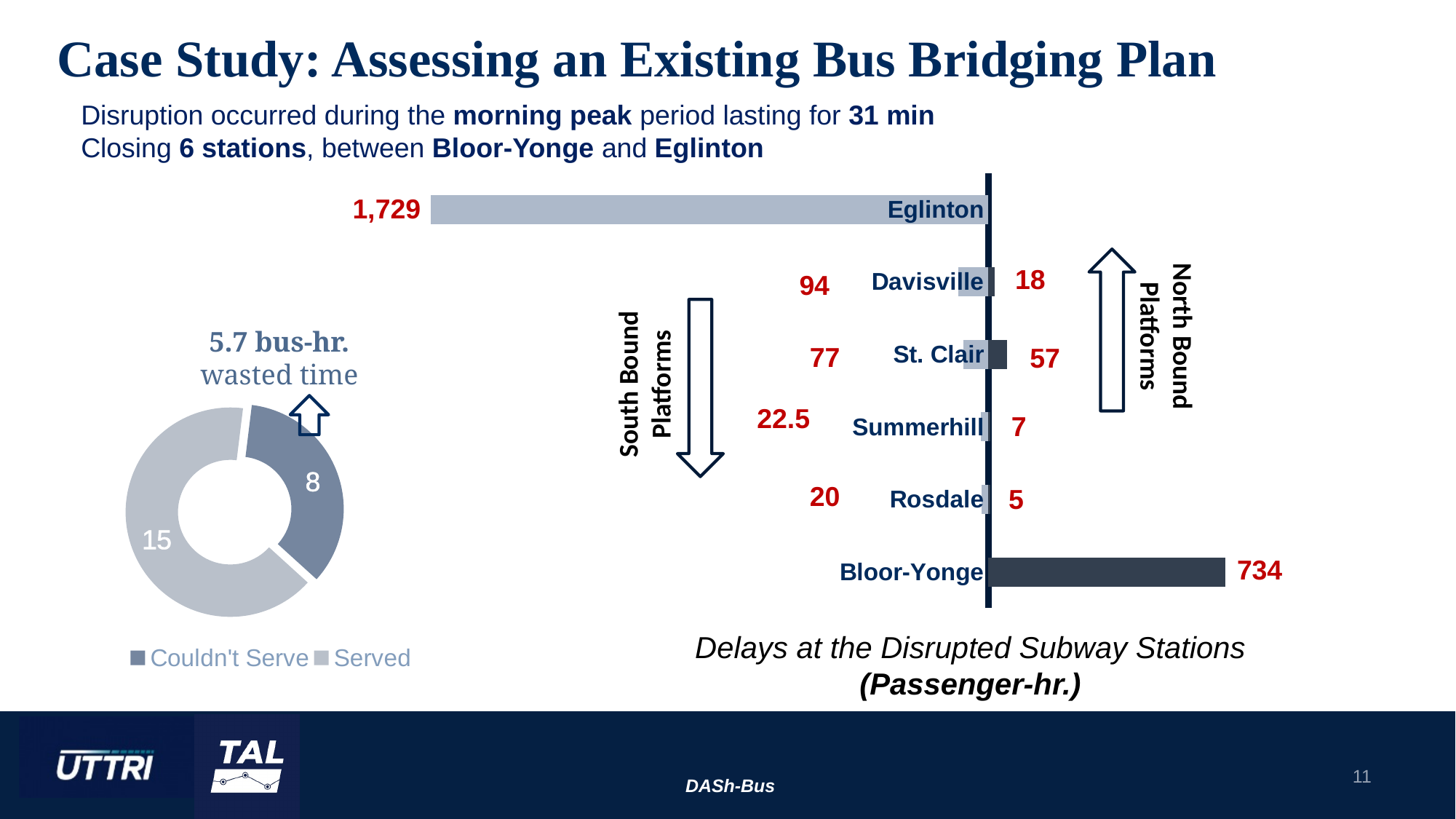
In the Delays at the Disrupted Subway Stations chart, what is the North Bound delay at Bloor-Yonge? 734 In the doughnut chart on the left, what is the value for Couldn't Serve? 8 In the Delays at the Disrupted Subway Stations chart, what is the South Bound delay at Summerhill? 22.5 In the doughnut chart on the left, what is the total of Couldn't Serve and Served? 23 In the doughnut chart on the left, how many entries does the legend list? 2 In the Delays at the Disrupted Subway Stations chart, what is the difference between the South Bound and North Bound delays at Davisville? 76 In the doughnut chart on the left, what is the value for Served? 15 In the Delays at the Disrupted Subway Stations chart, which station has the highest South Bound delay? Eglinton In the Delays at the Disrupted Subway Stations chart, which station has the lowest North Bound delay? Rosdale In the Delays at the Disrupted Subway Stations chart, what is the South Bound delay at Eglinton? 1,729 In the Delays at the Disrupted Subway Stations chart, how many stations are listed? 6 In the Delays at the Disrupted Subway Stations chart, what is the North Bound delay at St. Clair? 57